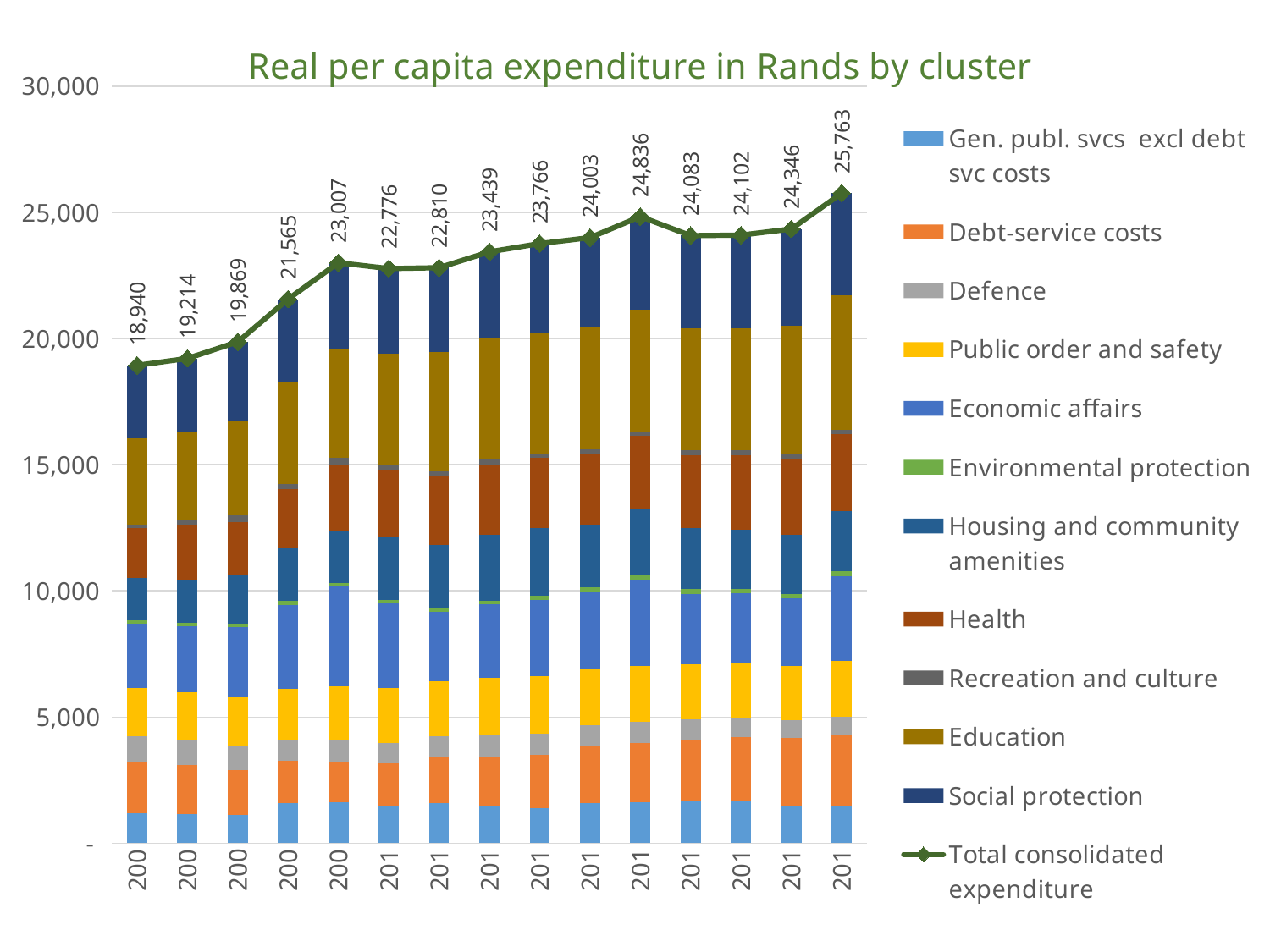
What is the title of the chart? Real per capita expenditure in Rands by cluster Does the Total consolidated expenditure line generally rise or fall from left to right? rise How many bars (years) are plotted on the chart? 15 What colour is the Total consolidated expenditure line in the legend? dark green Which bar has the highest Total consolidated expenditure, and what is its value? the last (rightmost) bar, 25,763 Which is larger: the Total consolidated expenditure of the eleventh bar from the left or of the twelfth bar from the left? the eleventh bar (24,836) Which bar has the lowest Total consolidated expenditure, and what is its value? the first (leftmost) bar, 18,940 What is the Total consolidated expenditure value labelled on the first (leftmost) bar? 18,940 How many series does the legend list? 12 What kind of chart is shown on the slide? stacked bar chart with a line What is the difference between the Total consolidated expenditure of the last bar (25,763) and the first bar (18,940)? 6,823 What is the Total consolidated expenditure value labelled on the last (rightmost) bar? 25,763